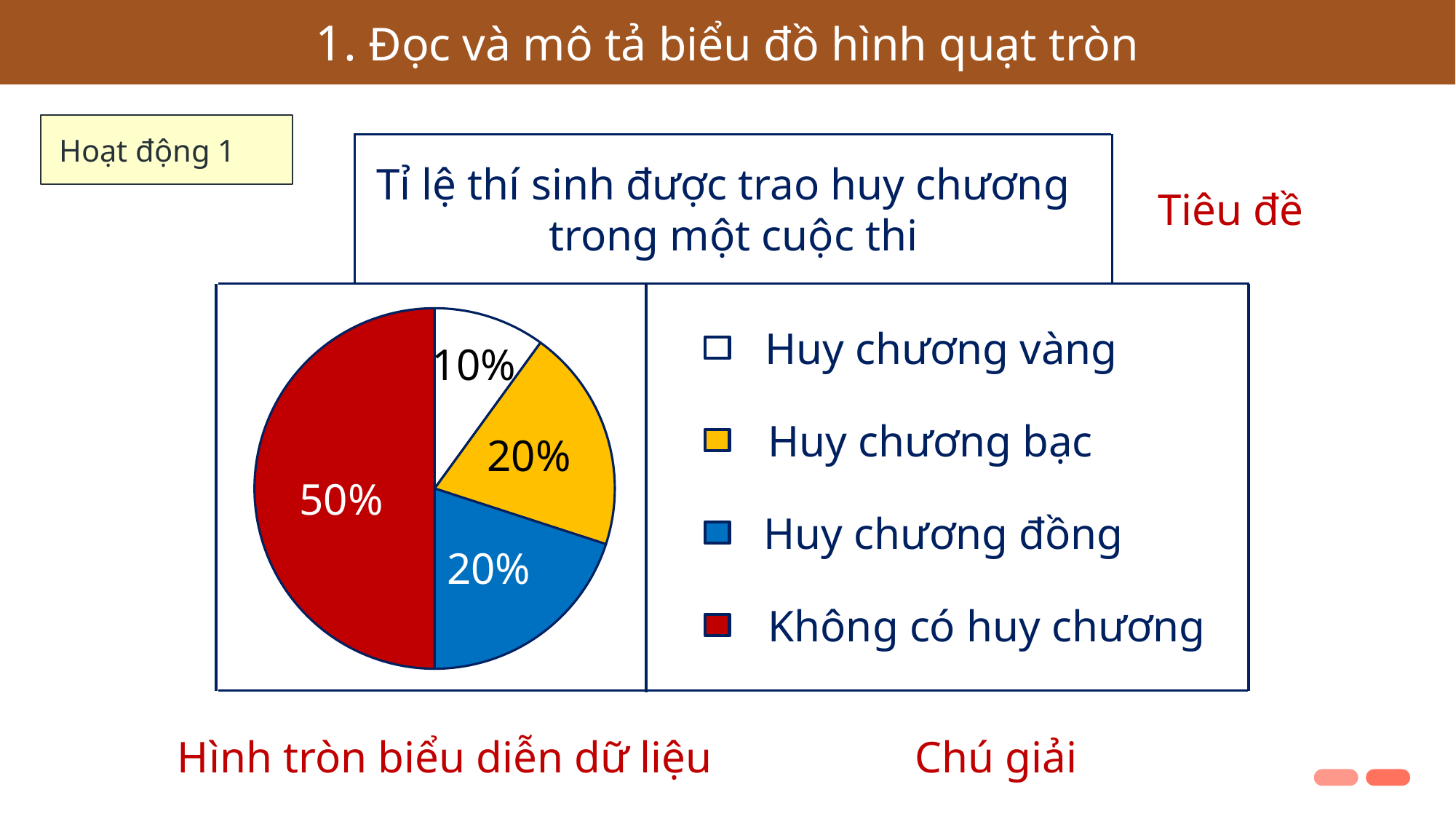
Which category has the smallest slice of the pie? Huy chương vàng How many slices does the pie chart have? 4 What kind of chart is shown on the slide? Pie chart Which colour represents Huy chương bạc in the pie chart? Yellow What percentage of the pie is labelled for Huy chương bạc? 20% Which category has the largest slice of the pie? Không có huy chương What percentage of the pie is labelled for Huy chương đồng? 20% How many entries does the legend list? 4 What is the difference in percentage points between Không có huy chương and Huy chương vàng? 40% What is the title of the pie chart? Tỉ lệ thí sinh được trao huy chương trong một cuộc thi What percentage of the pie is labelled for Không có huy chương? 50% What percentage of the pie is labelled for Huy chương vàng? 10%